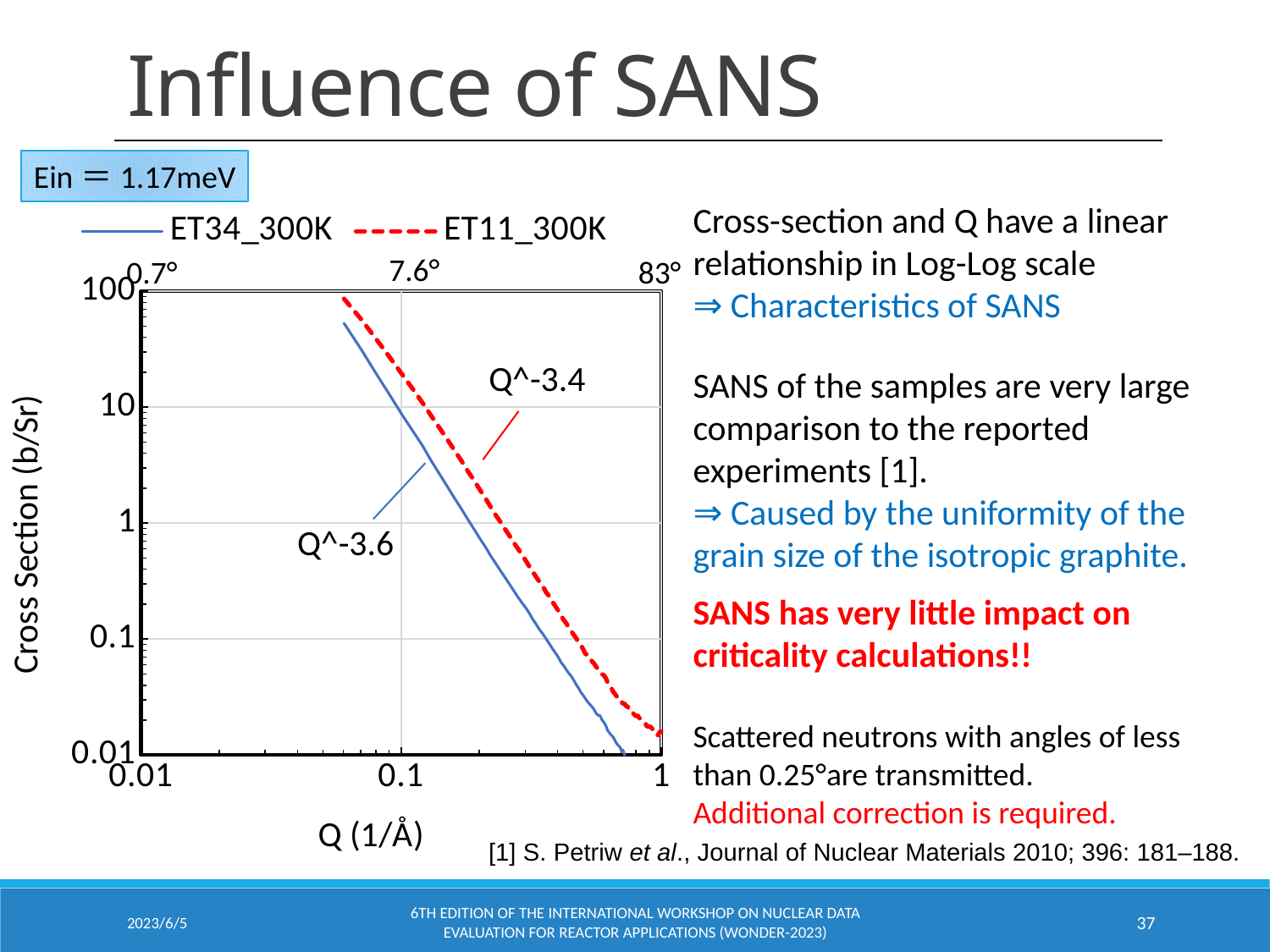
Is the cross section of ET34_300K at Q = 0.1 (1/Å) greater or less than 1 b/Sr? greater What power-law slope is annotated next to the ET34_300K curve? Q^-3.6 How many series does the chart legend list? 2 What power-law slope is annotated next to the ET11_300K curve? Q^-3.4 Which series is drawn as a red dashed line? ET11_300K Which series has the higher cross section at Q = 0.1 (1/Å), ET34_300K or ET11_300K? ET11_300K Is the cross section of ET11_300K at Q = 0.1 (1/Å) greater or less than 10 b/Sr? greater What is the label of the y axis of the chart? Cross Section (b/Sr) Is the cross section of ET34_300K at Q = 0.5 (1/Å) greater or less than 1 b/Sr? less Do the cross-section values rise or fall as Q increases along the x axis? fall What are the two series named in the chart legend? ET34_300K and ET11_300K What kind of chart is shown on the slide? line chart